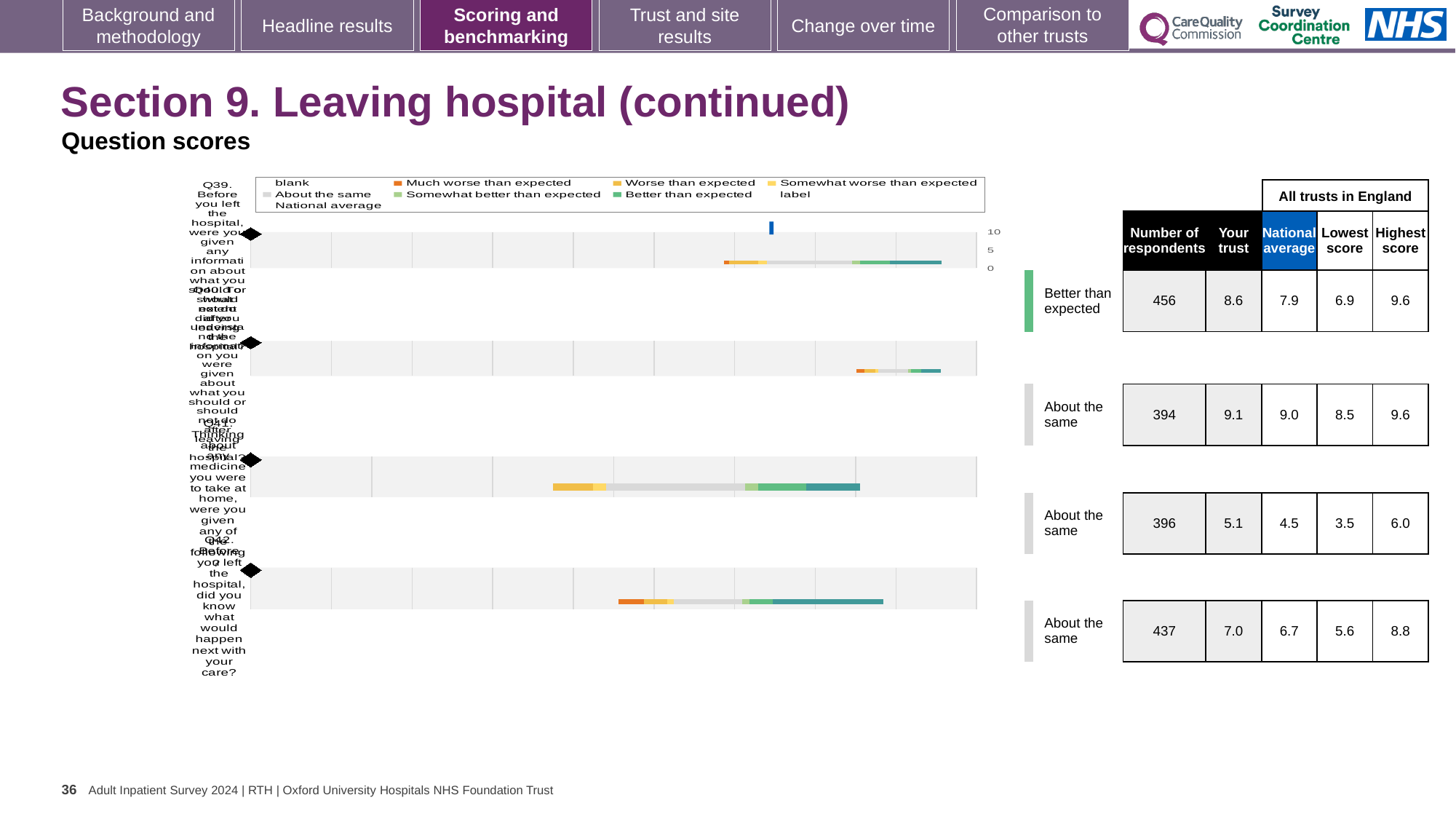
What kind of chart is used to show the question scores on this slide? bar chart In the table, what is the 'Your trust' score in the row labelled 'Better than expected'? 8.6 In the table, what is the difference between 'Your trust' and the national average in the row with 437 respondents? 0.3 In the table, what is the national average in the row with 396 respondents? 4.5 What is the maximum value shown on the axis of the question charts? 10 In the chart legend, which colour represents 'Much worse than expected'? orange In the table, how many respondents are in the row labelled 'Better than expected'? 456 In the table, what is the highest score in the row with 437 respondents? 8.8 In the table, which row has the lowest 'Your trust' score? the row with 396 respondents (5.1) In the table, is the 'Your trust' score in the row with 394 respondents larger or smaller than the national average in that row? larger In the table, what is the lowest score in the row with 396 respondents? 3.5 How many separate question charts are stacked on the left of the slide? 4